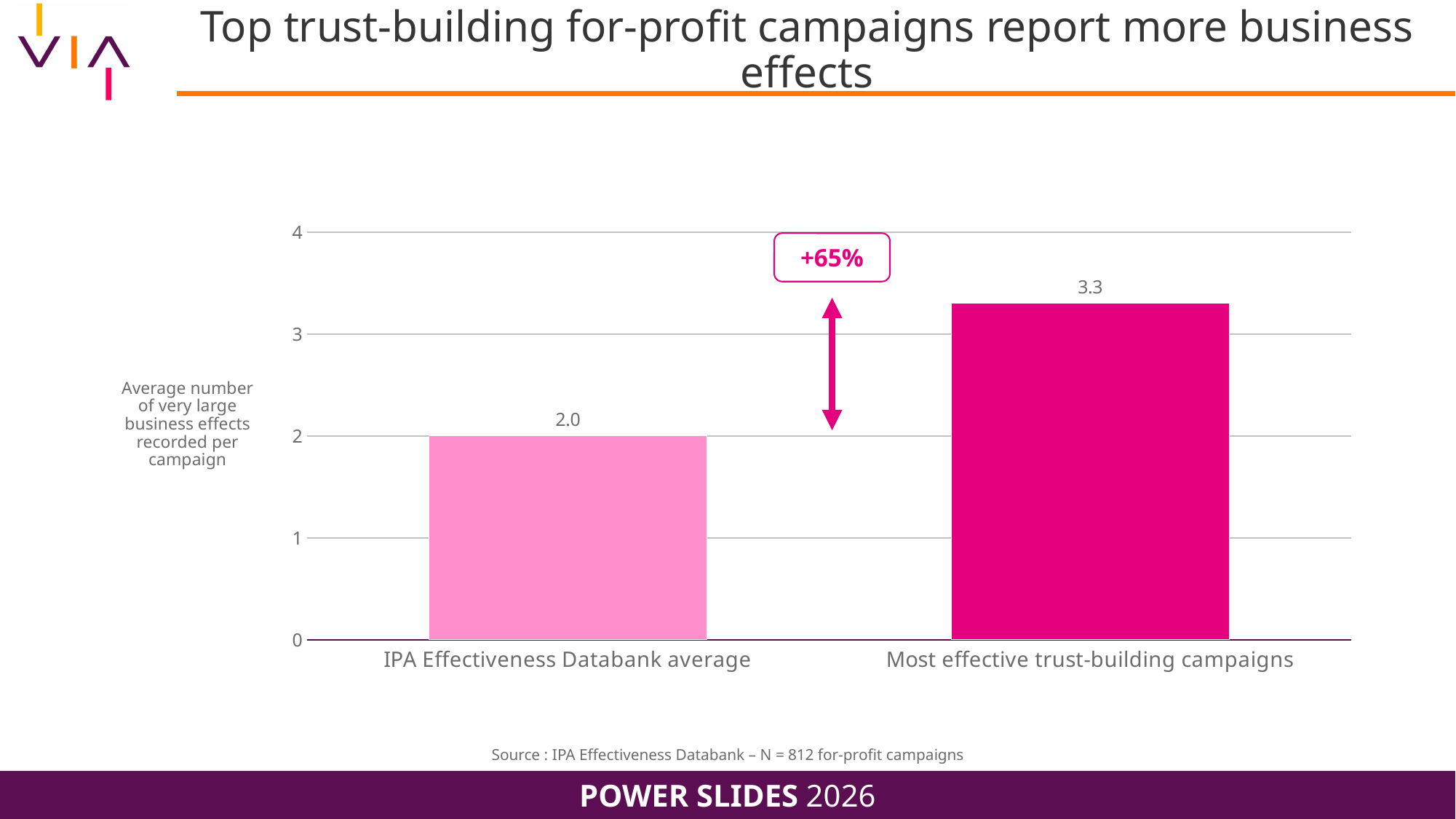
Which category has the highest value? Most effective trust-building campaigns What is the difference between the values for Most effective trust-building campaigns and IPA Effectiveness Databank average? 1.3 What is the value for Most effective trust-building campaigns? 3.3 What percentage increase is shown in the callout between the two bars? +65% Is the value for Most effective trust-building campaigns greater or less than 3? greater Which category has the lowest value? IPA Effectiveness Databank average Which is larger: the value for IPA Effectiveness Databank average or for Most effective trust-building campaigns? Most effective trust-building campaigns What is the highest value shown on the vertical axis? 4 What kind of chart is shown on the slide? Bar chart What is the label on the vertical axis of the chart? Average number of very large business effects recorded per campaign What is the value for IPA Effectiveness Databank average? 2.0 How many categories are shown in the chart? 2